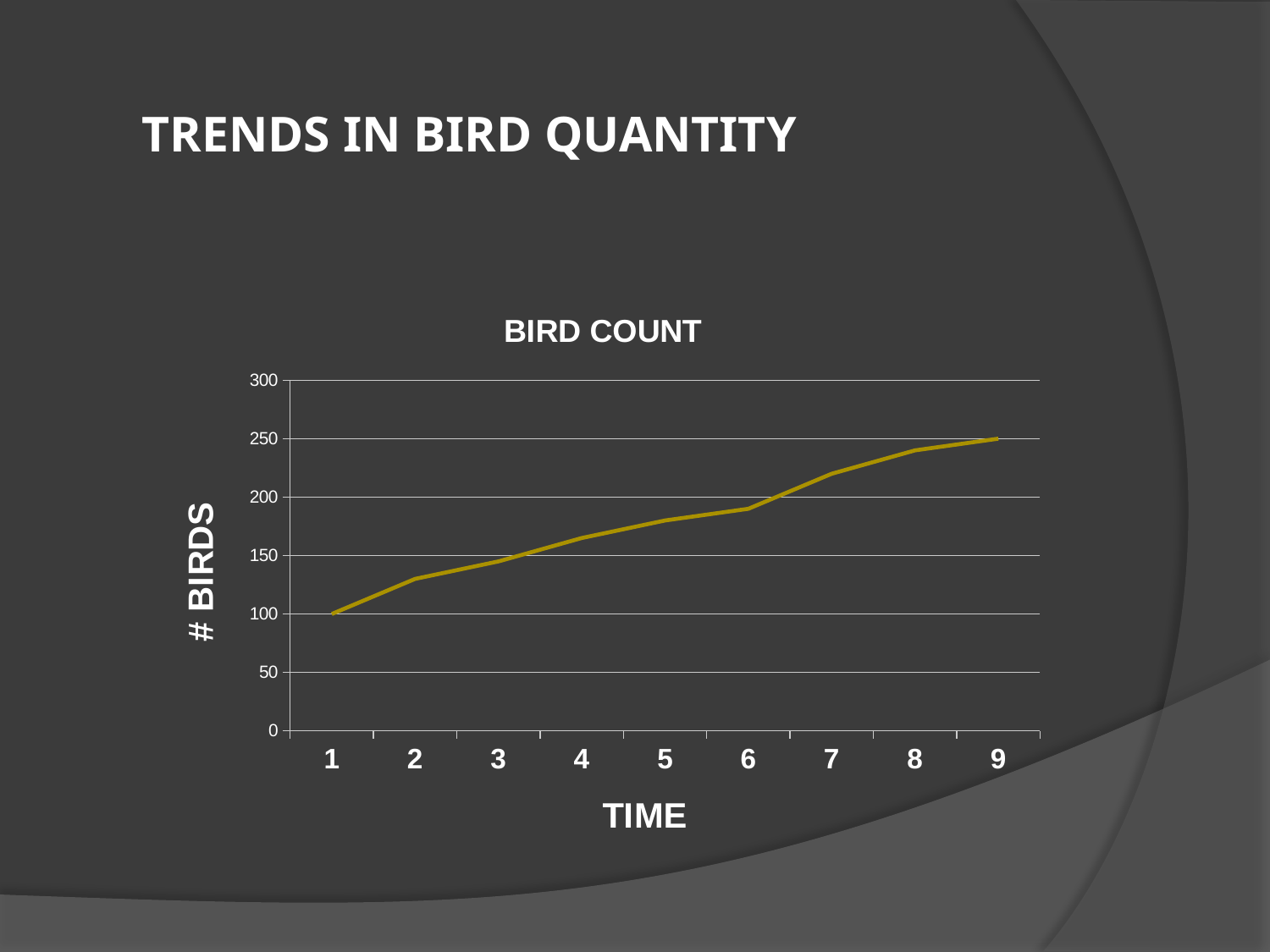
At which time is the number of birds highest? 9 Which is larger, the number of birds at time 4 or at time 8? time 8 What is the number of birds at time 1? 100 Is the value at time 7 greater or less than 200? greater What is the title of the chart? BIRD COUNT What is the label of the vertical axis? # BIRDS What kind of chart is shown on the slide? line chart Do the values rise or fall as time goes from 1 to 9? rise At which time is the number of birds lowest? 1 How many time points are plotted on the x axis? 9 Is the value at time 2 greater or less than 150? less What is the number of birds at time 9? 250